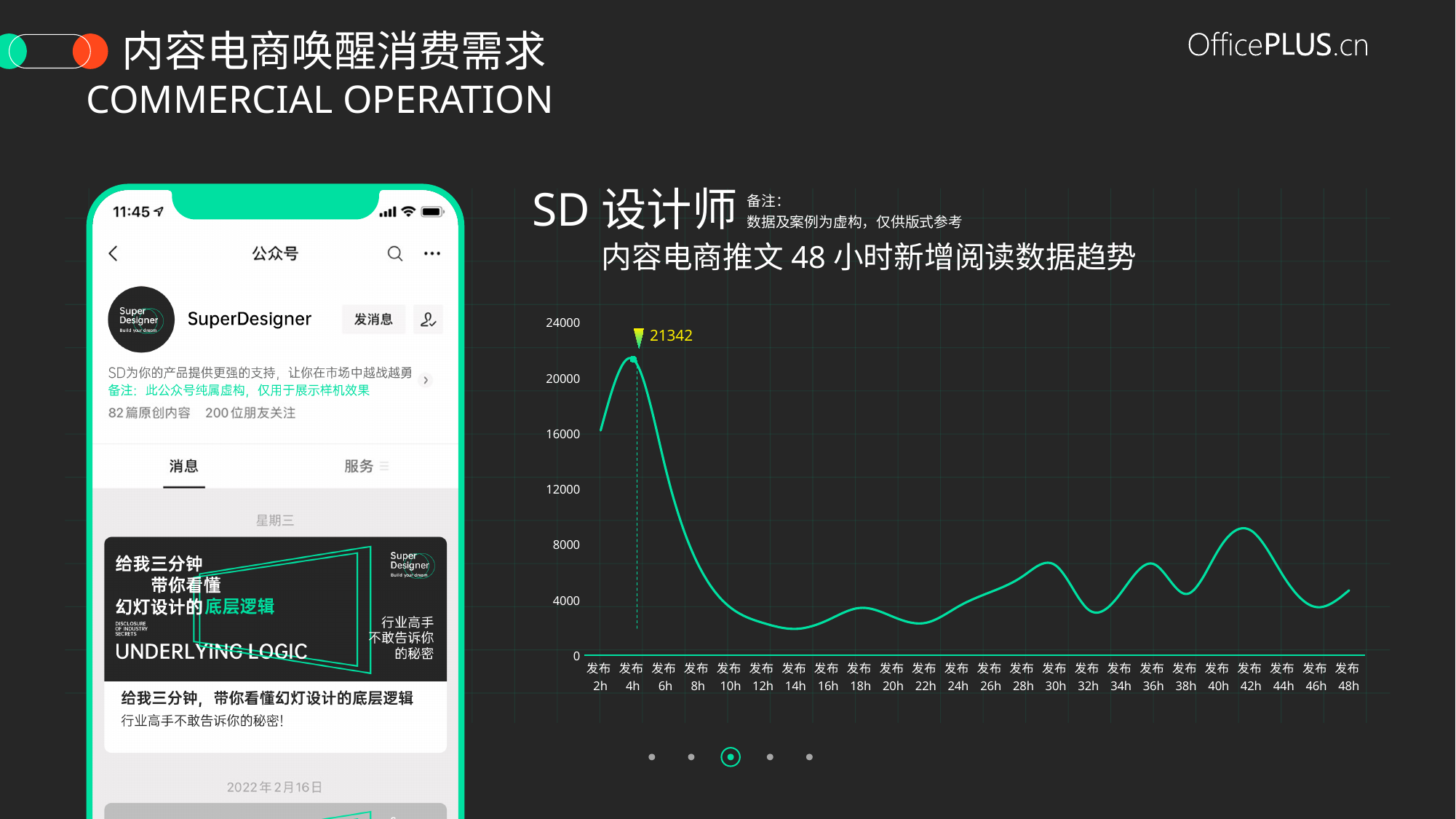
What is the highest tick value shown on the chart's y axis? 24000 Is the value for 发布10h greater or less than 8000? less Which is larger, the value at 发布4h or the value at 发布42h? 发布4h What kind of chart is shown on the slide? line chart What is the value labelled at 发布4h on the line chart? 21342 What is the title of the chart? 内容电商推文 48 小时新增阅读数据趋势 Do the values rise or fall from 发布4h to 发布14h? fall Is the value for 发布14h greater or less than 4000? less Is the value for 发布42h greater or less than 8000? greater At which time point does the line chart reach its highest value? 发布4h How many time points are plotted along the x axis of the chart? 24